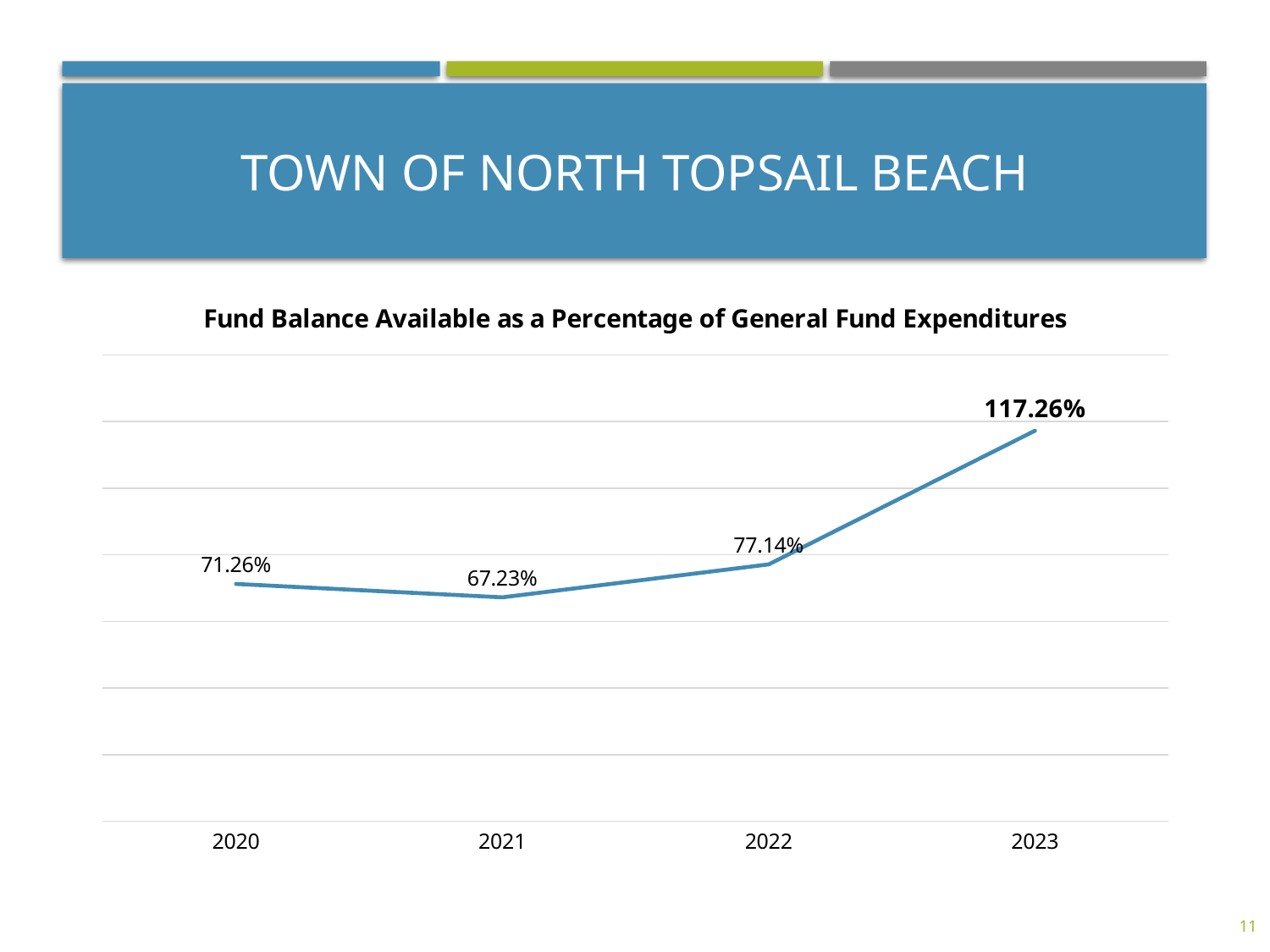
Which year has the highest fund balance percentage? 2023 What is the fund balance available as a percentage of general fund expenditures for 2020? 71.26% How many years are plotted on the chart? 4 Which year has the lowest fund balance percentage? 2021 What is the difference between the 2023 value and the 2022 value? 40.12% What is the value shown for 2023? 117.26% What kind of chart is shown on the slide? Line chart What is the value shown for 2022? 77.14% What is the difference between the 2020 value and the 2021 value? 4.03% What is the value shown for 2021? 67.23% What is the title of the chart? Fund Balance Available as a Percentage of General Fund Expenditures Which is larger, the value for 2020 or the value for 2022? 2022